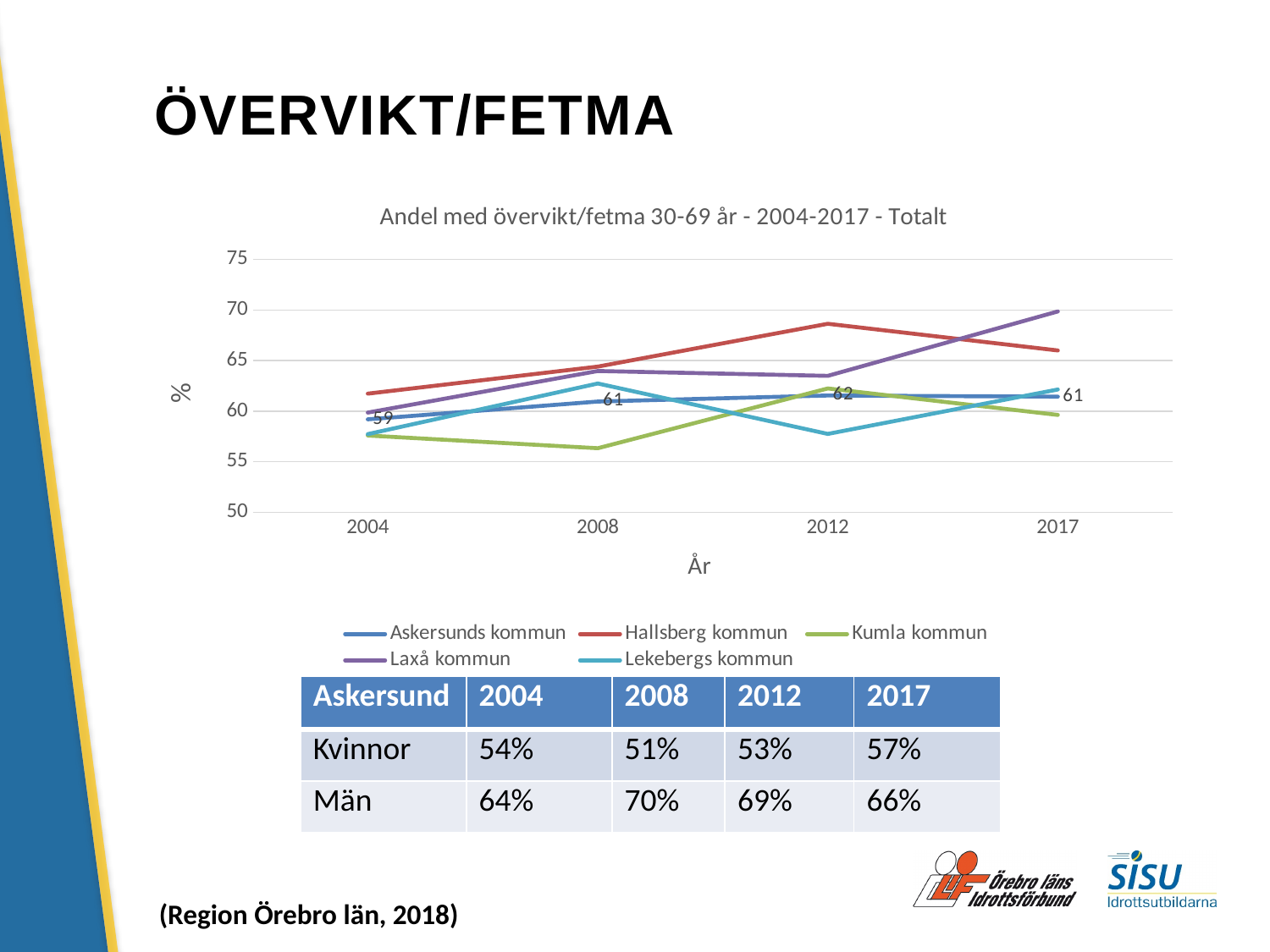
Which is higher in 2017, Laxå kommun or Askersunds kommun? Laxå kommun What is the value for Askersunds kommun in 2004? 59 Is the value for Kumla kommun in 2008 greater or less than 60? less How many years are shown on the x axis? 4 What is the value for Askersunds kommun in 2012? 62 How many series does the legend list? 5 What kind of chart is shown on the slide? Line chart In which year does Askersunds kommun reach its highest value? 2012 What is the title of the chart? Andel med övervikt/fetma 30-69 år - 2004-2017 - Totalt Is the value for Hallsberg kommun in 2012 greater or less than 65? greater In which year does Askersunds kommun have its lowest value? 2004 By how much did the value for Askersunds kommun increase from 2004 to 2012? 3